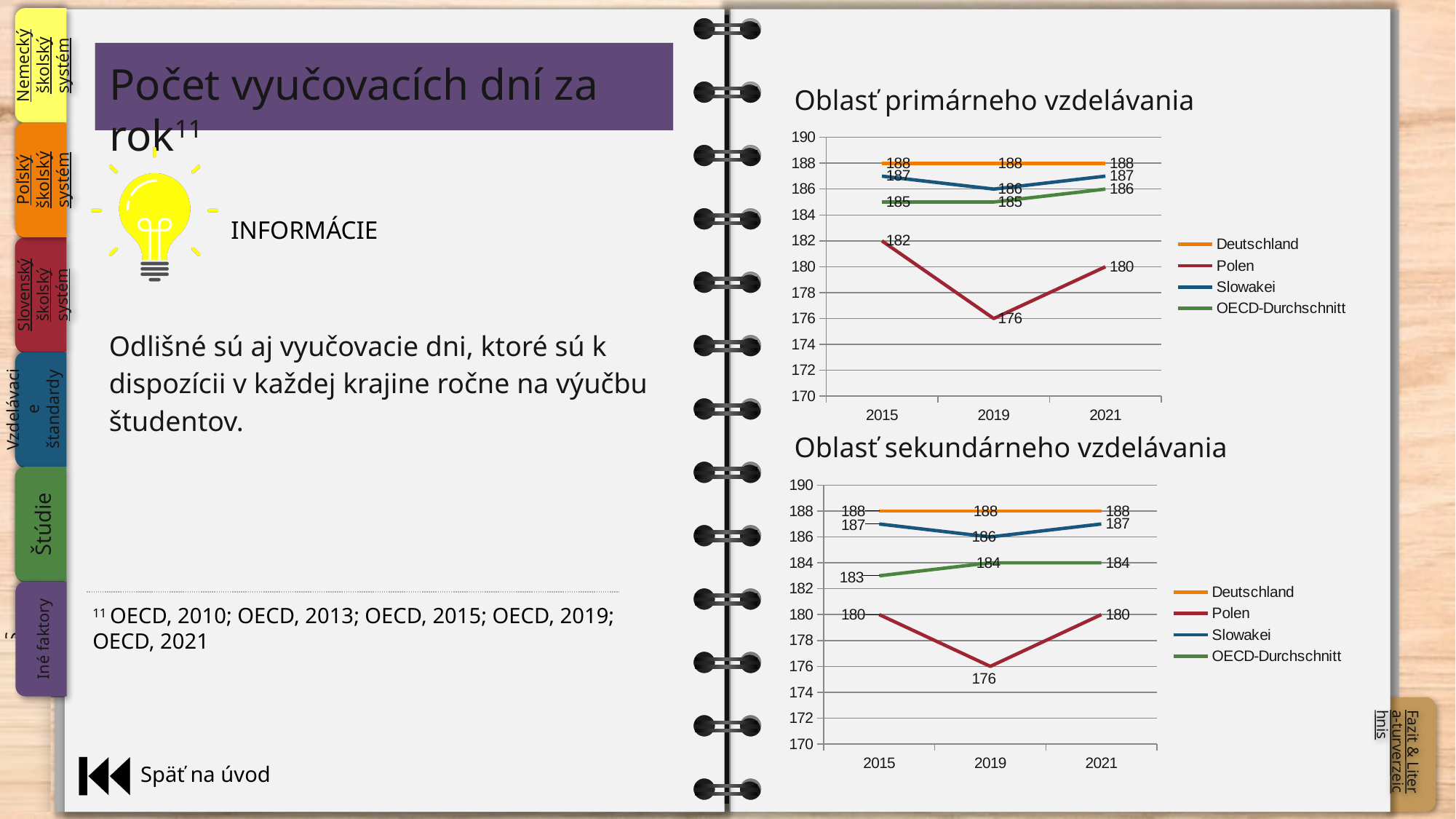
In the 'Oblasť sekundárneho vzdelávania' chart, what is the value for Slowakei in 2019? 186 In the 'Oblasť sekundárneho vzdelávania' chart, does the value for Polen rise or fall from 2019 to 2021? rise In the 'Oblasť primárneho vzdelávania' chart, what is the difference between Deutschland and Polen in 2015? 6 In the 'Oblasť primárneho vzdelávania' chart, which series has the lowest value in 2019? Polen In the 'Oblasť sekundárneho vzdelávania' chart, which series has the highest value in 2021? Deutschland In the 'Oblasť primárneho vzdelávania' chart, what is the value for OECD-Durchschnitt in 2021? 186 What kind of chart is 'Oblasť sekundárneho vzdelávania'? line chart In the 'Oblasť primárneho vzdelávania' chart, what is the value for Polen in 2019? 176 In the 'Oblasť sekundárneho vzdelávania' chart, what is the value for OECD-Durchschnitt in 2015? 183 In the 'Oblasť sekundárneho vzdelávania' chart, is the value for Polen in 2015 larger or smaller than the value for OECD-Durchschnitt in 2015? smaller In the 'Oblasť sekundárneho vzdelávania' chart, what is the difference between Slowakei and Polen in 2019? 10 How many series does the legend of the 'Oblasť primárneho vzdelávania' chart list? 4